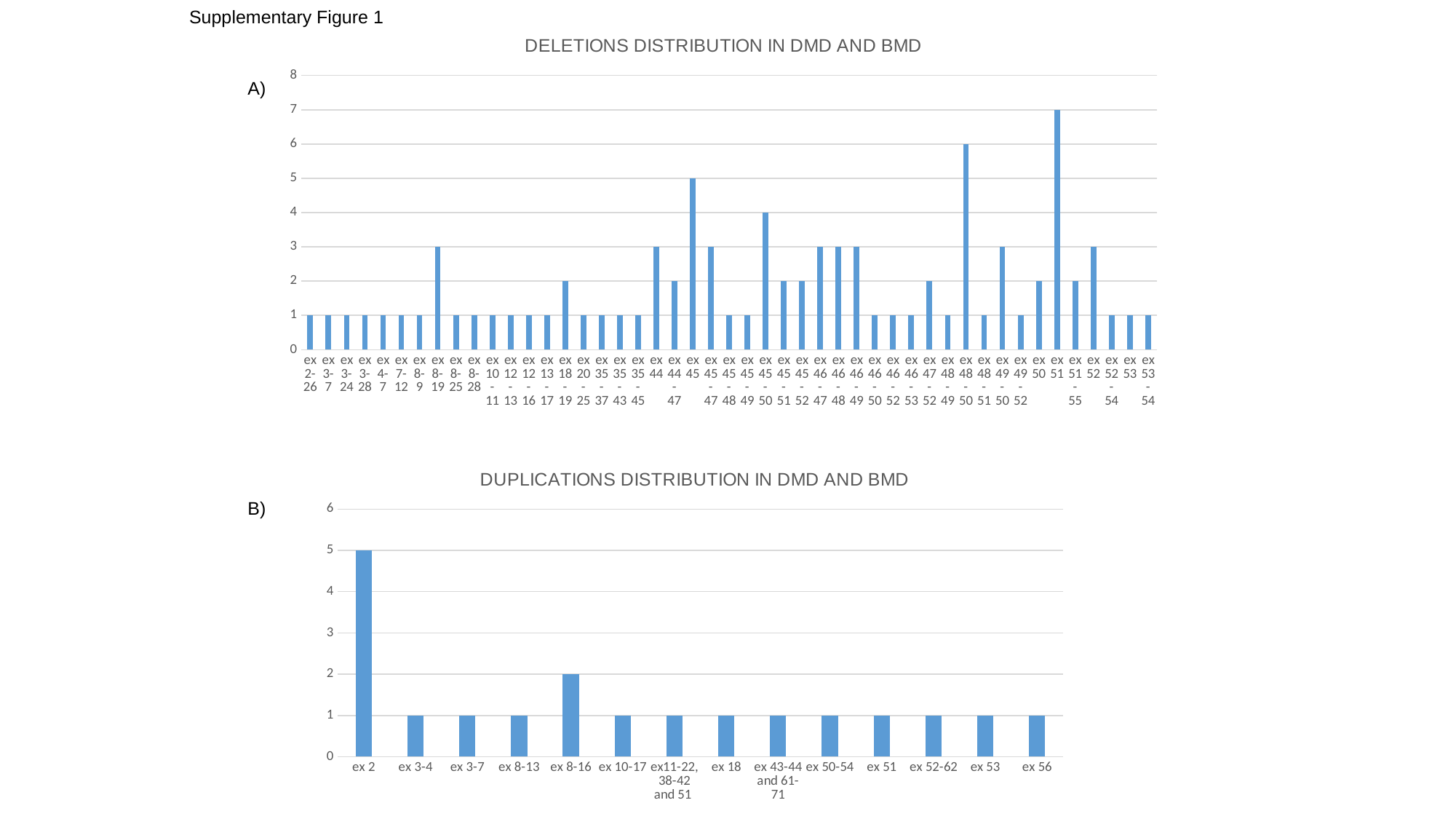
In the DUPLICATIONS DISTRIBUTION IN DMD AND BMD chart, what is the value for ex 8-16? 2 In the DELETIONS DISTRIBUTION IN DMD AND BMD chart, what is the value for ex 51? 7 What kind of chart is the DUPLICATIONS DISTRIBUTION IN DMD AND BMD chart? Bar chart In the DUPLICATIONS DISTRIBUTION IN DMD AND BMD chart, how many categories are shown on the x axis? 14 In the DUPLICATIONS DISTRIBUTION IN DMD AND BMD chart, what is the difference between the values for ex 2 and ex 8-16? 3 In the DELETIONS DISTRIBUTION IN DMD AND BMD chart, which is larger, the value for ex 51 or the value for ex 45? ex 51 What is the title of the top chart on the slide (panel A)? DELETIONS DISTRIBUTION IN DMD AND BMD In the DUPLICATIONS DISTRIBUTION IN DMD AND BMD chart, what is the value for ex 56? 1 In the DELETIONS DISTRIBUTION IN DMD AND BMD chart, is the value for ex 51 greater or less than 6? greater In the DUPLICATIONS DISTRIBUTION IN DMD AND BMD chart, what is the value for ex 2? 5 In the DELETIONS DISTRIBUTION IN DMD AND BMD chart, which category has the highest value? ex 51 In the DUPLICATIONS DISTRIBUTION IN DMD AND BMD chart, which category has the highest value? ex 2